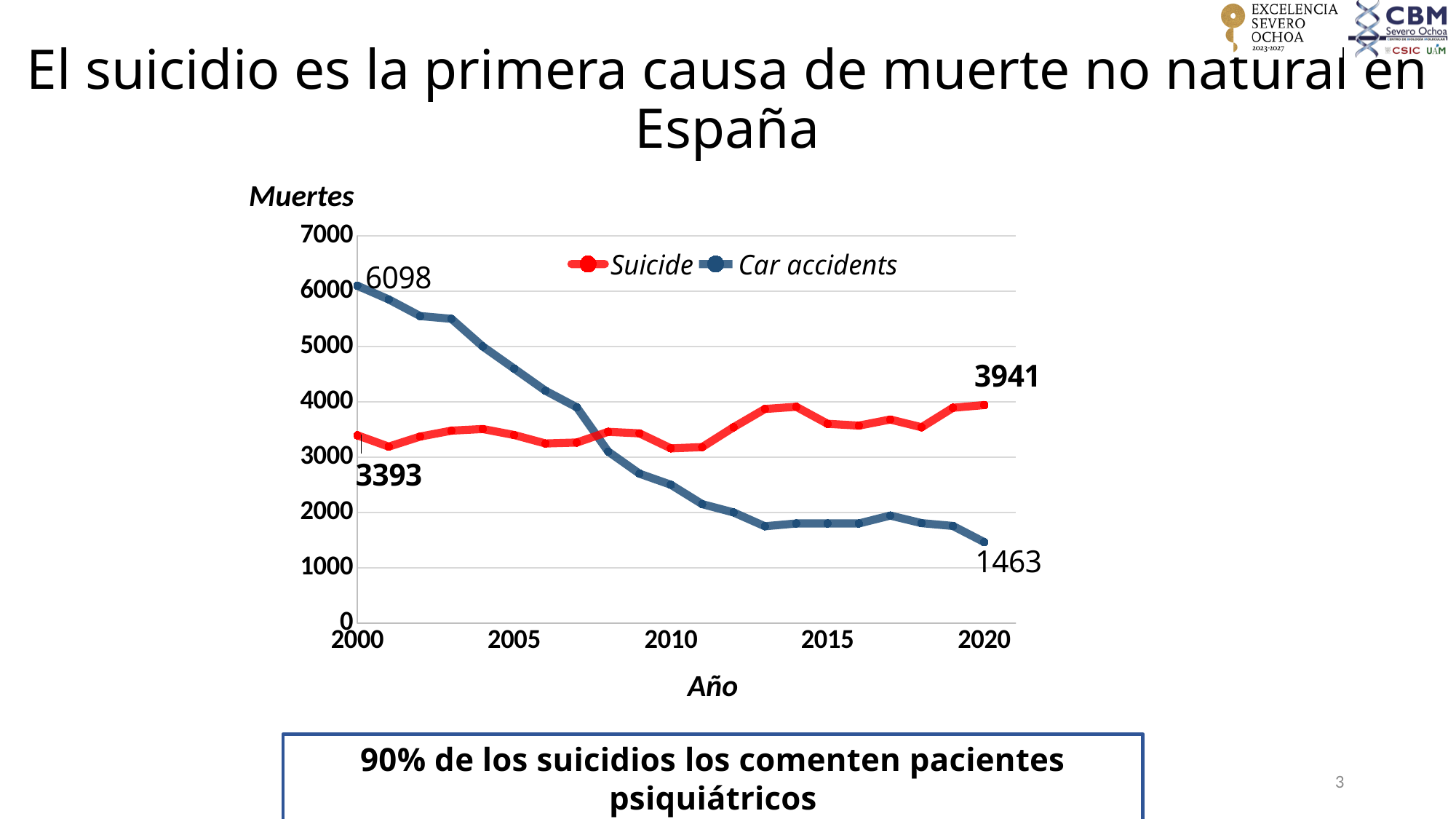
What is the value for Car accidents in 2020? 1463 By how much did Car accidents deaths fall between 2000 and 2020? 4635 What is the value for Suicide in 2020? 3941 What kind of chart is shown on the slide? line chart How many series does the chart legend list? 2 What are the two series named in the chart legend? Suicide and Car accidents Is the value for Car accidents in 2010 greater or less than 3000? less By how much did Suicide deaths increase between 2000 and 2020? 548 Does the Car accidents series rise or fall from 2000 to 2020? fall In 2020, which series has the higher value, Suicide or Car accidents? Suicide What is the value for Car accidents in 2000? 6098 What is the value for Suicide in 2000? 3393